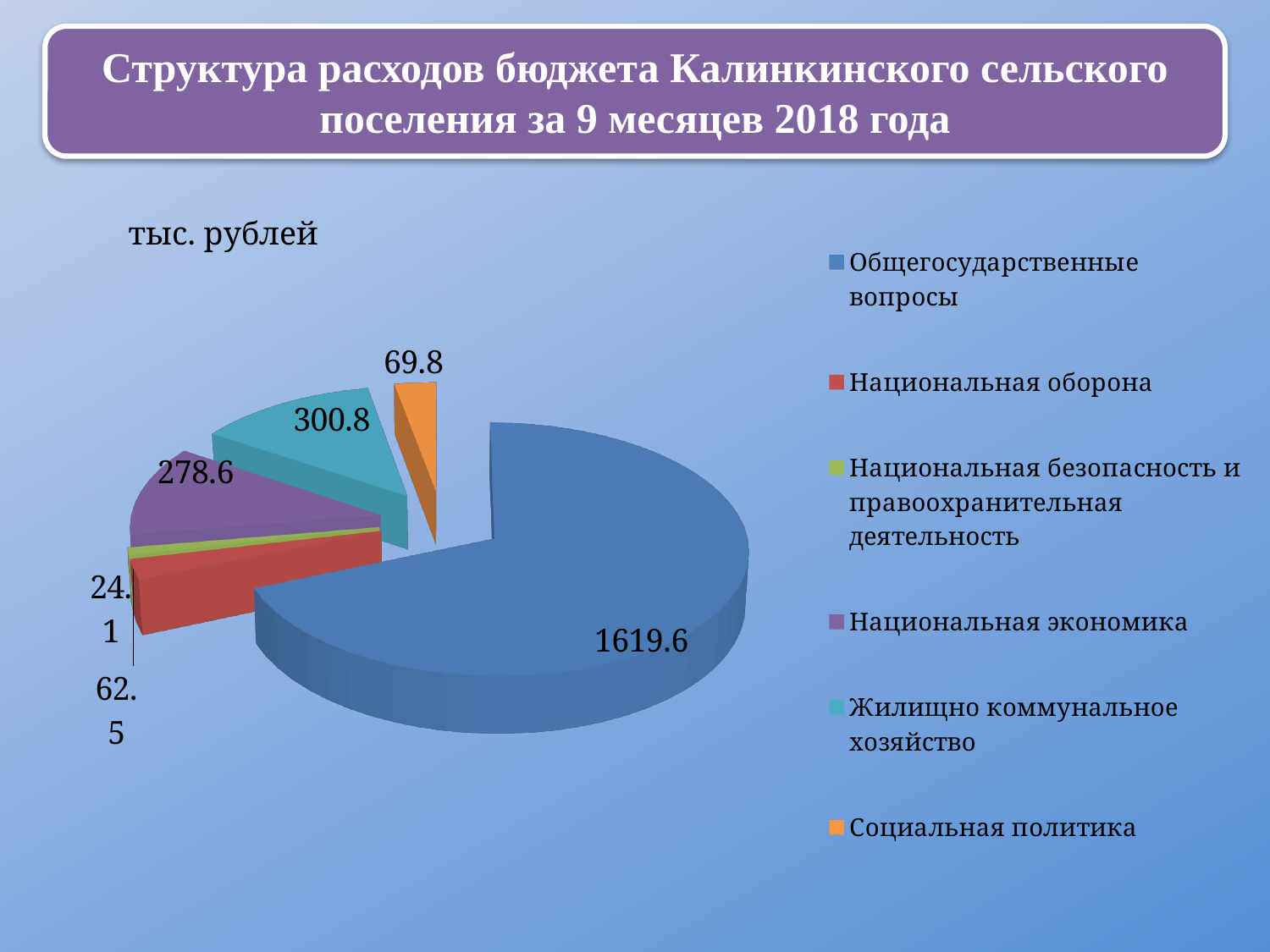
What is the value for Национальная экономика? 278.6 What type of chart is shown on the slide? Pie chart What is the value for Общегосударственные вопросы? 1619.6 What is the value for Социальная политика? 69.8 What is the value for Жилищно коммунальное хозяйство? 300.8 Which is larger, the value for Социальная политика or the value for Национальная оборона? Социальная политика In what units are the values on the chart expressed? тыс. рублей Which category has the smallest slice of the pie? Национальная безопасность и правоохранительная деятельность What is the difference between the values for Жилищно коммунальное хозяйство and Национальная экономика? 22.2 What is the value for Национальная оборона? 62.5 How many categories does the legend of the pie chart list? 6 Which category has the largest slice of the pie? Общегосударственные вопросы